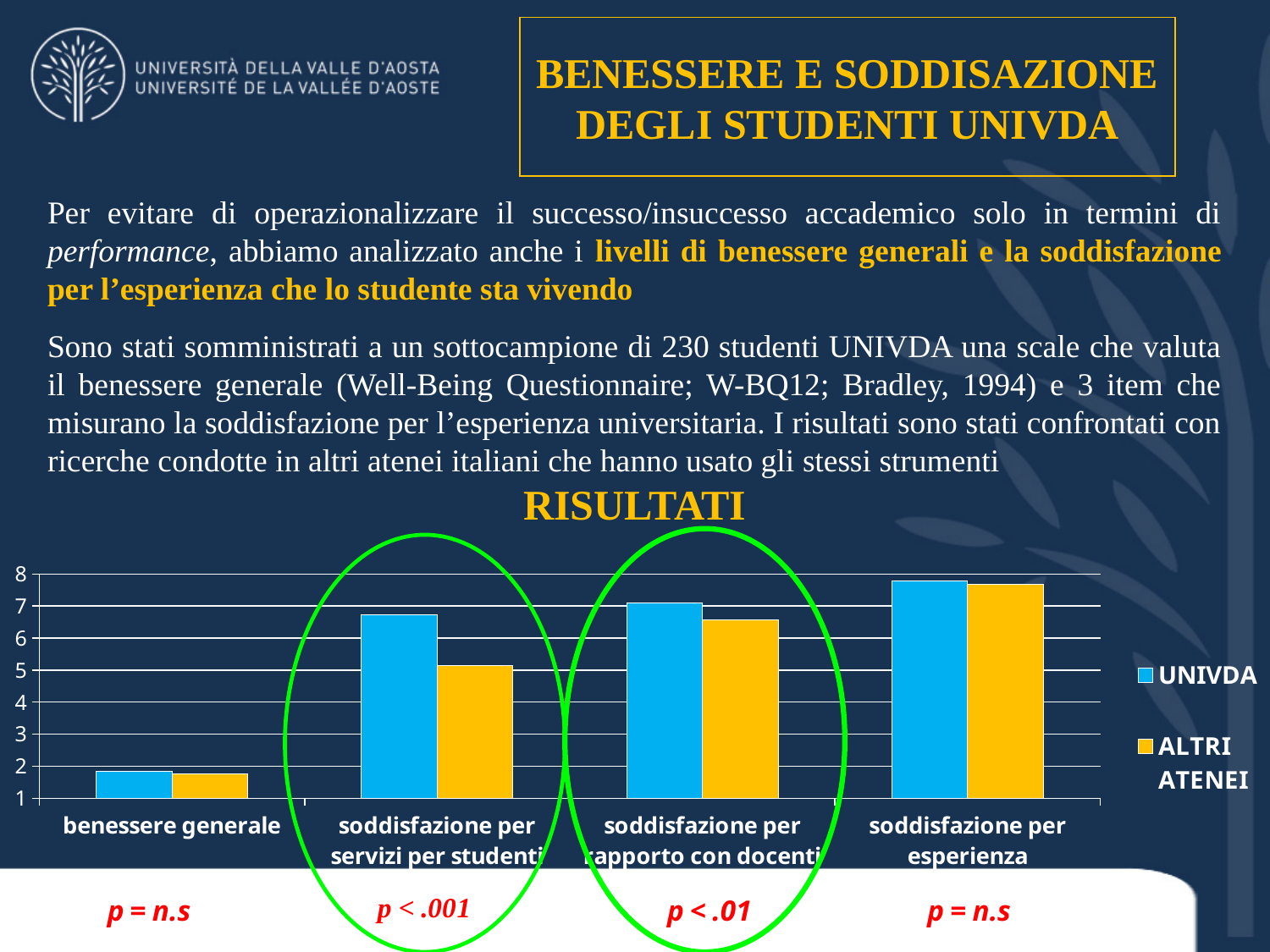
Is the ALTRI ATENEI value for 'soddisfazione per servizi per studenti' greater or less than 6? less Is the ALTRI ATENEI value for 'soddisfazione per rapporto con docenti' greater or less than 7? less Which category has the lowest ALTRI ATENEI value? benessere generale How many series does the chart legend list? 2 For 'soddisfazione per rapporto con docenti', which series has the larger value, UNIVDA or ALTRI ATENEI? UNIVDA What is the title shown above the chart? RISULTATI Which colour represents the UNIVDA series in the chart? blue Which category has the highest UNIVDA value? soddisfazione per esperienza Is the UNIVDA value for 'soddisfazione per servizi per studenti' greater or less than 6? greater What kind of chart is shown on the slide? bar chart For 'soddisfazione per servizi per studenti', which series has the larger value, UNIVDA or ALTRI ATENEI? UNIVDA How many categories are shown on the x axis of the chart? 4